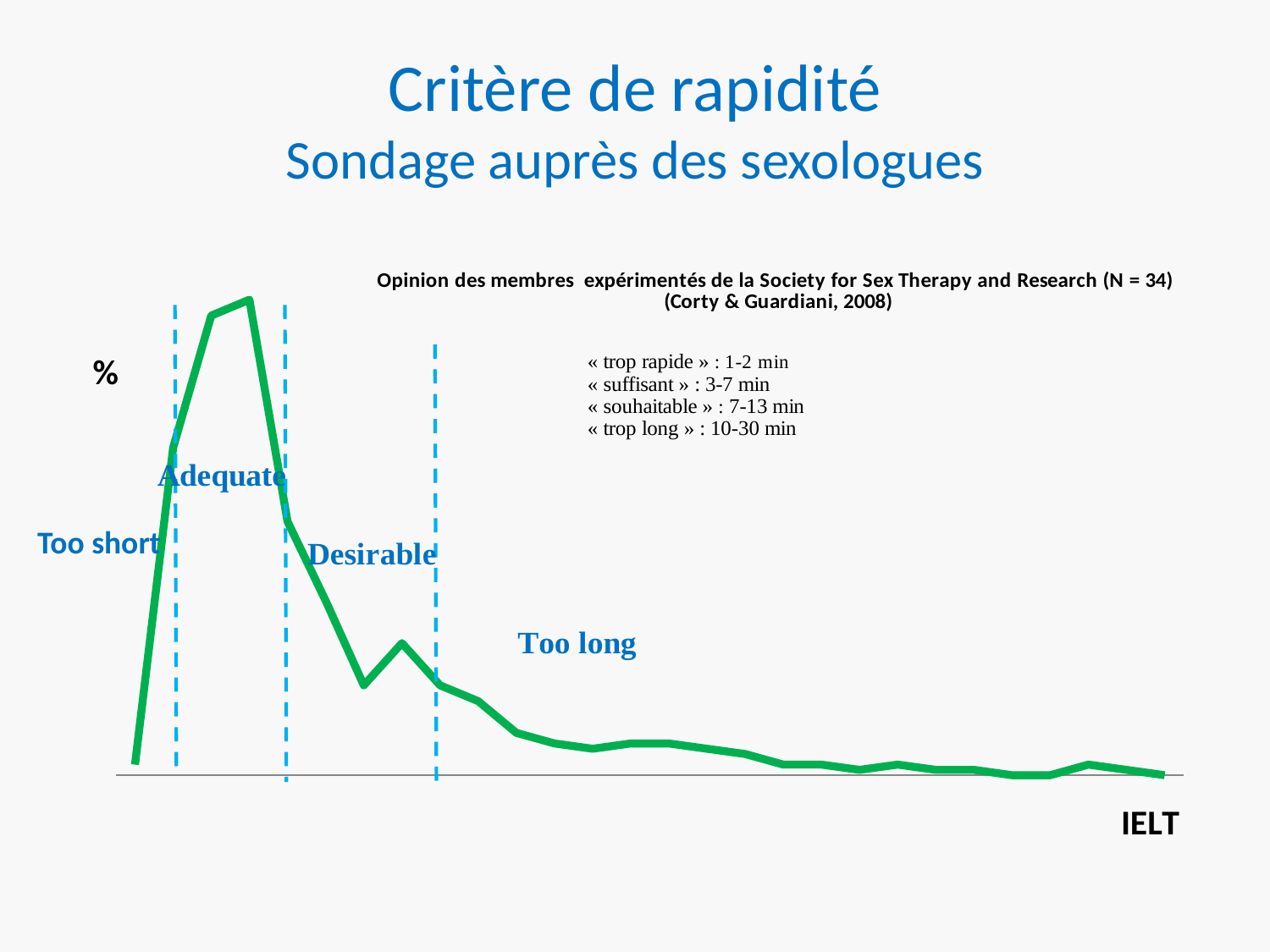
Is the green line higher in the Desirable region or in the Too long region? Desirable Is the green line higher in the Adequate region or in the Too long region? Adequate What kind of chart is shown on the slide? line chart How many labelled regions (Too short, Adequate, Desirable, Too long) are marked on the chart? 4 What is the label on the x axis of the chart? IELT How many lines (data series) are plotted on the chart? 1 In which labelled region of the chart is the green line lowest? Too long In which labelled region of the chart does the green line reach its peak? Adequate After its peak, does the green line rise or fall as IELT increases along the x axis? fall How many dashed vertical lines divide the chart into regions? 3 What is the label on the y axis of the chart? %